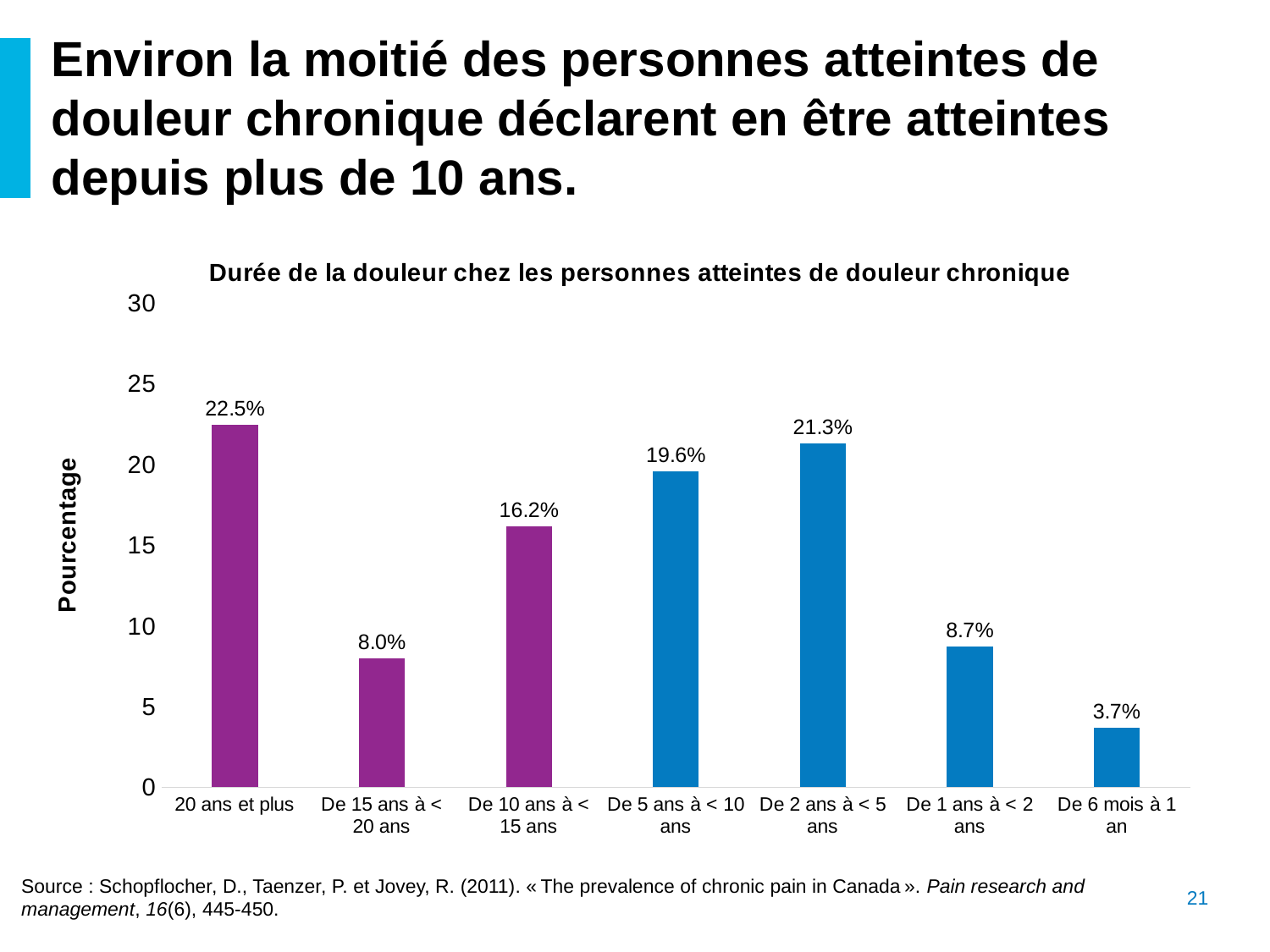
What is the value for "De 6 mois à 1 an"? 3.7% What is the value for "De 2 ans à < 5 ans"? 21.3% Which category has the highest value? 20 ans et plus What is the difference between the values for "De 5 ans à < 10 ans" and "De 10 ans à < 15 ans"? 3.4% Which category has the lowest value? De 6 mois à 1 an What is the title of the chart? Durée de la douleur chez les personnes atteintes de douleur chronique What kind of chart is shown on the slide? bar chart How many categories are shown on the x axis? 7 Which is larger, the value for "De 15 ans à < 20 ans" or the value for "De 1 ans à < 2 ans"? De 1 ans à < 2 ans Is the value for "De 10 ans à < 15 ans" greater or less than 15? greater What is the label of the y axis? Pourcentage What is the value for "20 ans et plus"? 22.5%